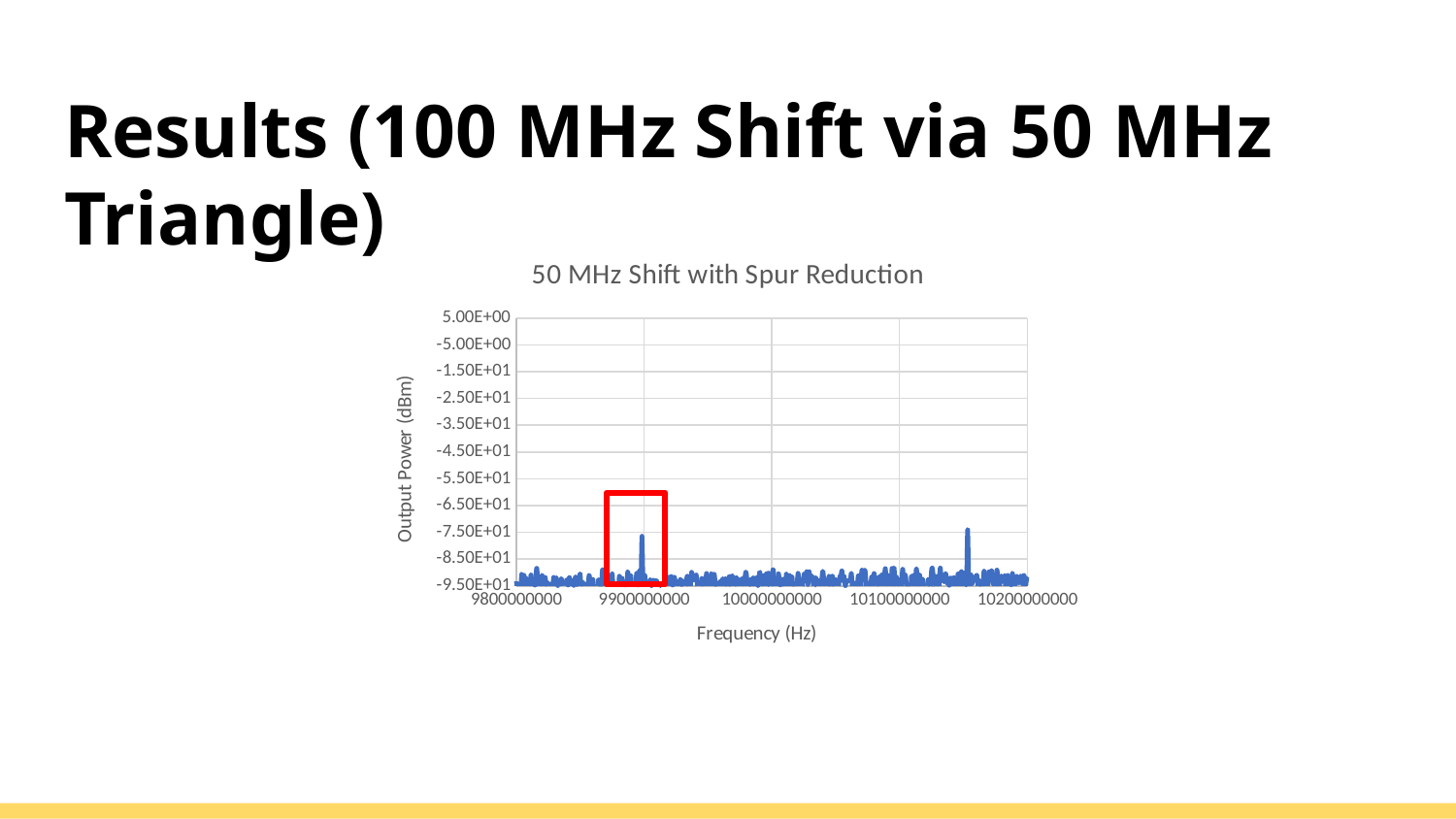
Is the value of the peak near 9900000000 Hz (inside the red box) greater or less than -8.50E+01 dBm? greater Is the value at 10000000000 Hz greater or less than -7.50E+01 dBm? less What kind of chart is shown on the slide? line chart What is the label of the y axis of the chart? Output Power (dBm) Is the noise floor of the trace (away from the peaks) greater or less than -8.50E+01 dBm? less What is the title of the chart? 50 MHz Shift with Spur Reduction Which peak is higher: the one near 9900000000 Hz or the one near 10150000000 Hz? the one near 10150000000 Hz